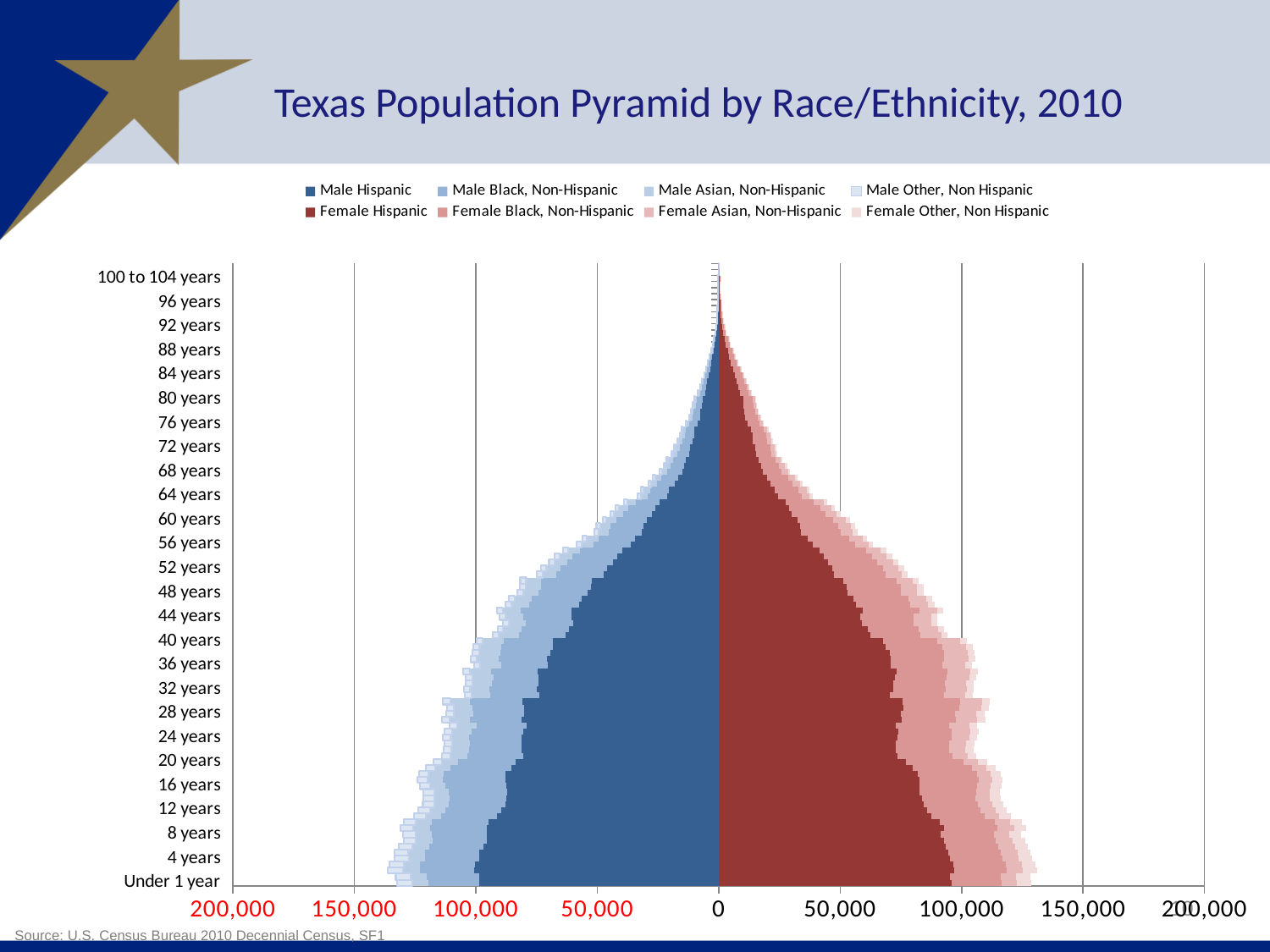
Which colour represents Male Hispanic in the chart? Dark blue Is the total female population bar for 28 years greater or less than 100,000? greater Is the Male Hispanic value for 60 years greater or less than 50,000? less Is the total male population bar for Under 1 year greater or less than 100,000? greater Which is larger, the total female population bar for 28 years or for 72 years? 28 years How many series does the legend list? 8 What is the title of the chart? Texas Population Pyramid by Race/Ethnicity, 2010 Do the population bars generally get larger or smaller as age increases from Under 1 year to 100 to 104 years? Smaller What kind of chart is shown on the slide? Bar chart (population pyramid) Which is larger, the Male Hispanic value for 20 years or for 60 years? 20 years